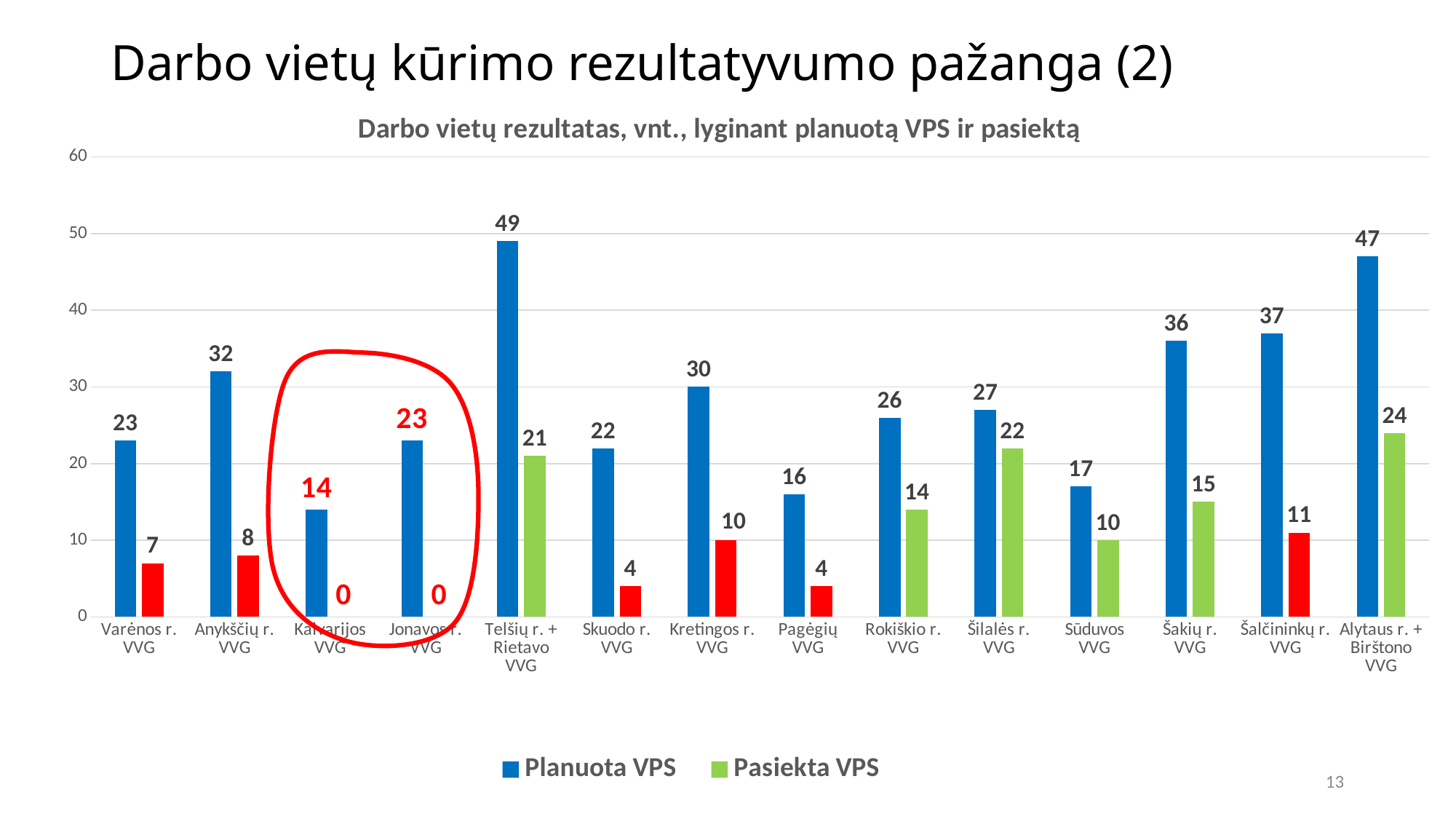
What is the Pasiekta VPS value for Šilalės r. VVG? 22 What kind of chart is shown on the slide? bar chart What is the difference between Planuota VPS and Pasiekta VPS for Šakių r. VVG? 21 What is the Pasiekta VPS value for Alytaus r. + Birštono VVG? 24 What is the Pasiekta VPS value for Jonavos r. VVG? 0 Which category has the highest Planuota VPS value? Telšių r. + Rietavo VVG How many series does the legend list? 2 Which is larger for Skuodo r. VVG: Planuota VPS or Pasiekta VPS? Planuota VPS Which category has the lowest Planuota VPS value? Kalvarijos VVG How many categories are shown on the x axis? 14 What is the title of the chart? Darbo vietų rezultatas, vnt., lyginant planuotą VPS ir pasiektą What is the Planuota VPS value for Telšių r. + Rietavo VVG? 49